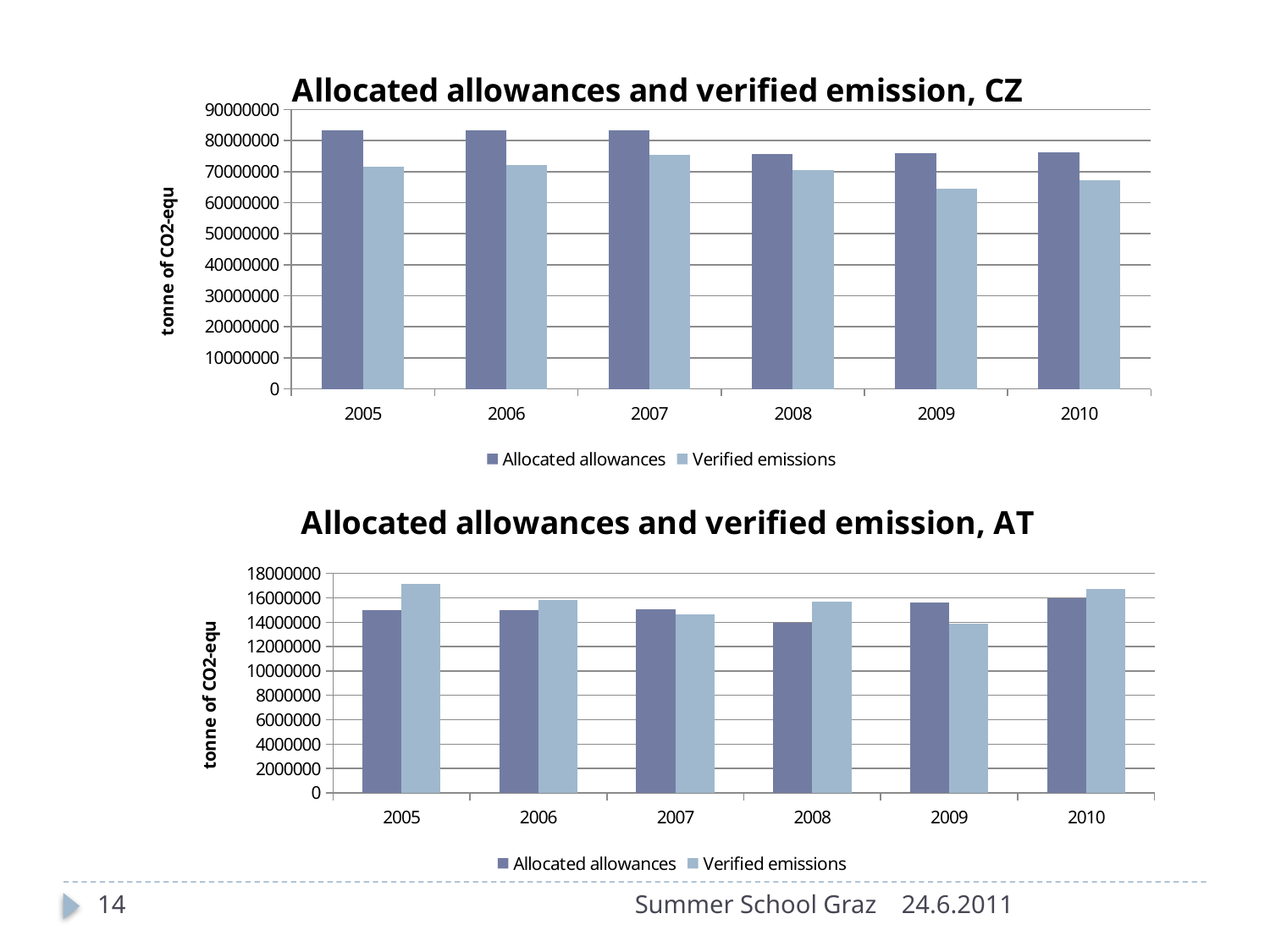
In the top chart (CZ), is the value for Verified emissions in 2009 greater or less than 70000000? less In the top chart (CZ), how many years are shown on the x axis? 6 In the bottom chart (AT), how many series does the legend list? 2 In the bottom chart (AT), which is larger in 2009: Allocated allowances or Verified emissions? Allocated allowances In the bottom chart (AT), which is larger in 2005: Allocated allowances or Verified emissions? Verified emissions In the top chart (CZ), in which year are Verified emissions lowest? 2009 In the top chart (CZ), is the value for Allocated allowances in 2005 greater or less than 80000000? greater In the bottom chart (AT), is the value for Verified emissions in 2005 greater or less than 16000000? greater In the top chart (CZ), which is larger in 2007: Allocated allowances or Verified emissions? Allocated allowances What is the y-axis label of the bottom chart (AT)? tonne of CO2-equ What kind of chart is the top chart, 'Allocated allowances and verified emission, CZ'? bar chart